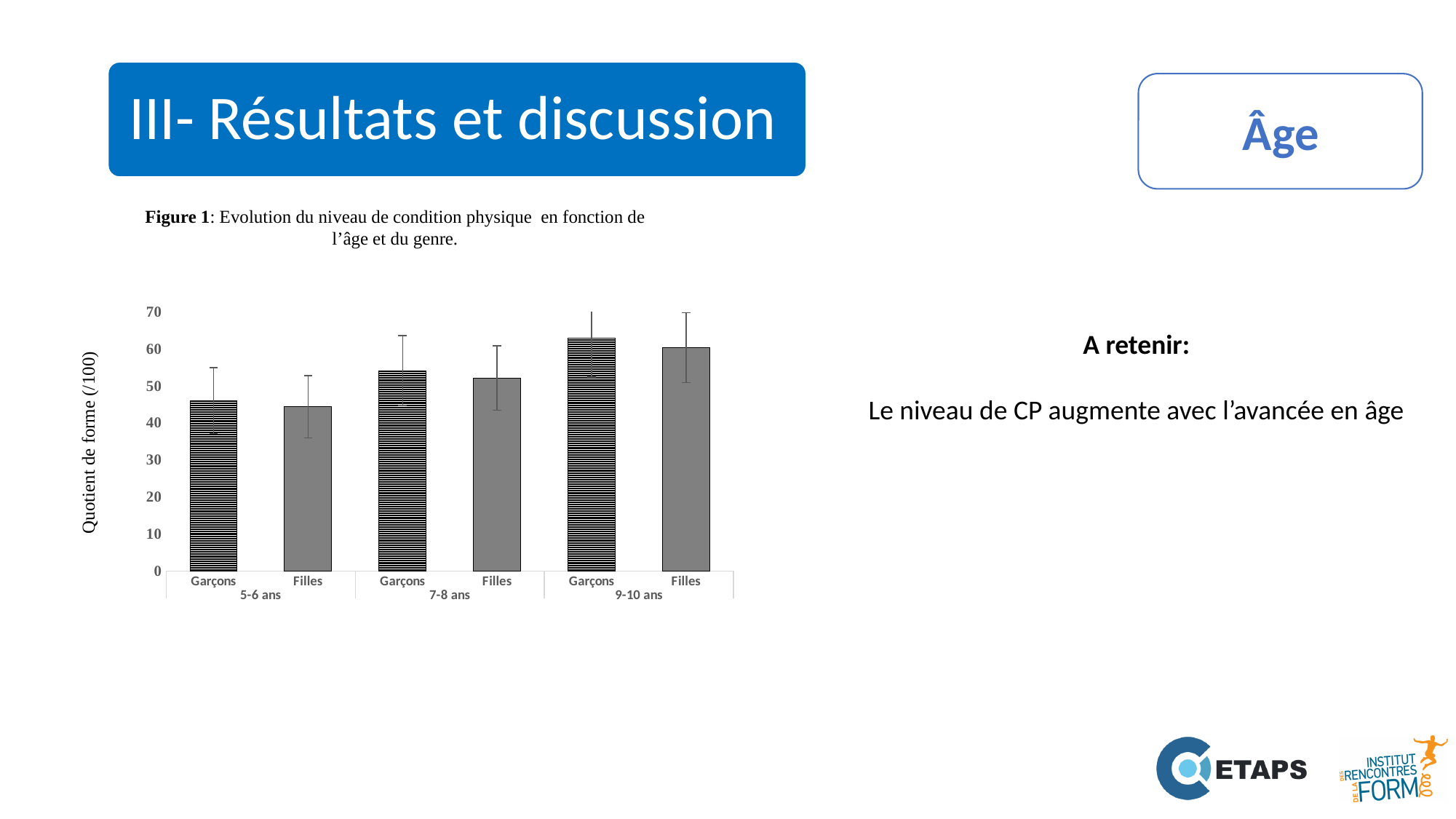
Which is larger: the value for Garçons in the 9-10 ans group or the value for Garçons in the 5-6 ans group? Garçons 9-10 ans Is the value for Garçons in the 9-10 ans group greater or less than 60? greater Is the value for Filles in the 7-8 ans group greater or less than 60? less How many age groups are shown on the x axis of the chart? 3 What is the label of the y axis of the chart? Quotient de forme (/100) Do the values for Garçons rise or fall as age increases along the x axis? rise Is the value for Garçons in the 5-6 ans group greater or less than 50? less Which is larger: the value for Filles in the 7-8 ans group or the value for Filles in the 5-6 ans group? Filles 7-8 ans What kind of chart is shown in Figure 1? bar chart How many bars are plotted in the chart? 6